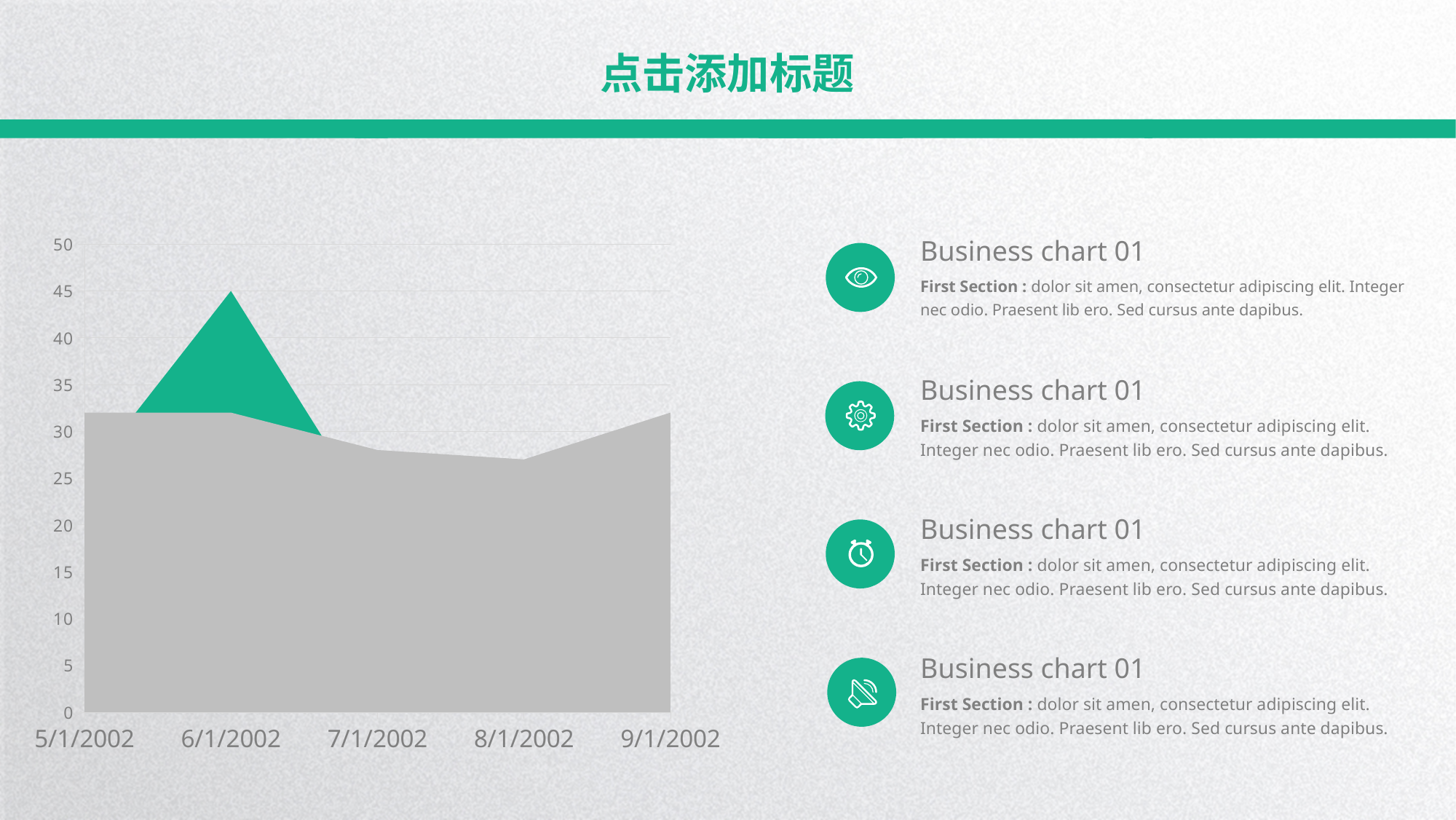
Is the value at 5/1/2002 greater or less than 25? greater Is the peak value of the green area at 6/1/2002 greater or less than 40? greater Do the values rise or fall from 6/1/2002 to 8/1/2002? fall Is the value of the gray area at 8/1/2002 greater or less than 30? less Do the values rise or fall from 8/1/2002 to 9/1/2002? rise On which date does the chart reach its highest value? 6/1/2002 What is the highest value shown on the y axis of the chart? 50 How many dates are shown on the x axis of the chart? 5 Which is larger, the value at 6/1/2002 or the value at 8/1/2002? 6/1/2002 What is the first date label on the x axis of the chart? 5/1/2002 What kind of chart is shown on the slide? area chart